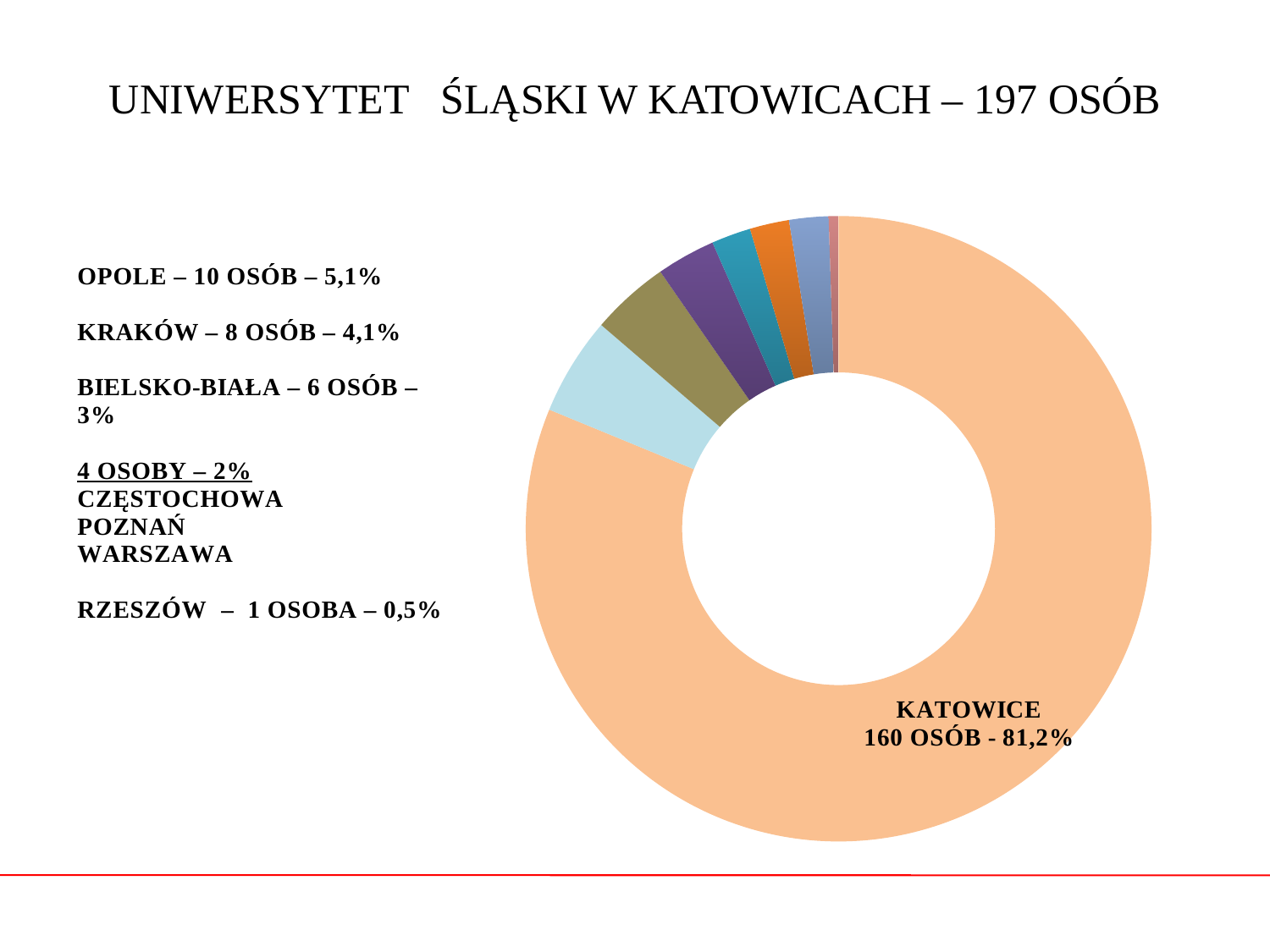
What is the total number of people represented by the chart? 197 OSÓB What percentage is given for Kraków? 4,1% How many slices does the doughnut chart have? 8 Which city has the smallest slice in the chart? Rzeszów Which city has the largest slice in the chart? Katowice What is the difference in number of people between Opole and Kraków? 2 What is the title of the slide above the chart? UNIWERSYTET ŚLĄSKI W KATOWICACH – 197 OSÓB What kind of chart is shown on the slide? Doughnut (pie) chart Which has more people, Opole or Bielsko-Biała? Opole How many people does the Katowice slice represent? 160 OSÓB How many people are listed for Opole? 10 OSÓB What share of the chart does Katowice account for? 81,2%